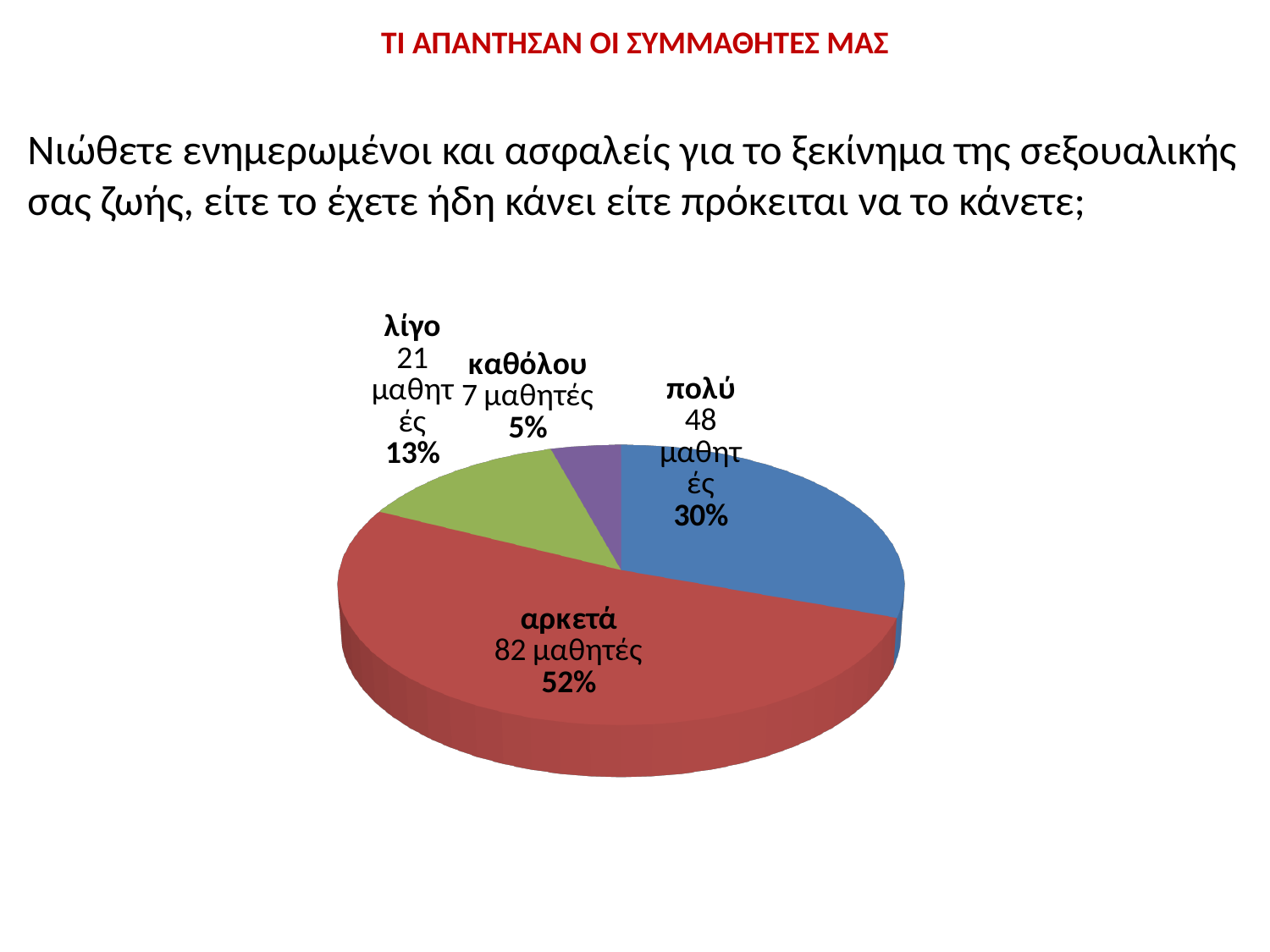
Which answer has the smallest slice of the pie? καθόλου What share of the pie does "αρκετά" represent? 52% What kind of chart is shown on the slide? pie chart What colour is the "αρκετά" slice? red What is the difference in number of students between "αρκετά" and "πολύ"? 34 Which has more students, "λίγο" or "καθόλου"? λίγο What share of the pie does "λίγο" represent? 13% How many students answered "πολύ"? 48 μαθητές How many students answered "αρκετά"? 82 μαθητές How many students answered "καθόλου"? 7 μαθητές How many slices does the pie chart have? 4 Which answer has the largest slice of the pie? αρκετά